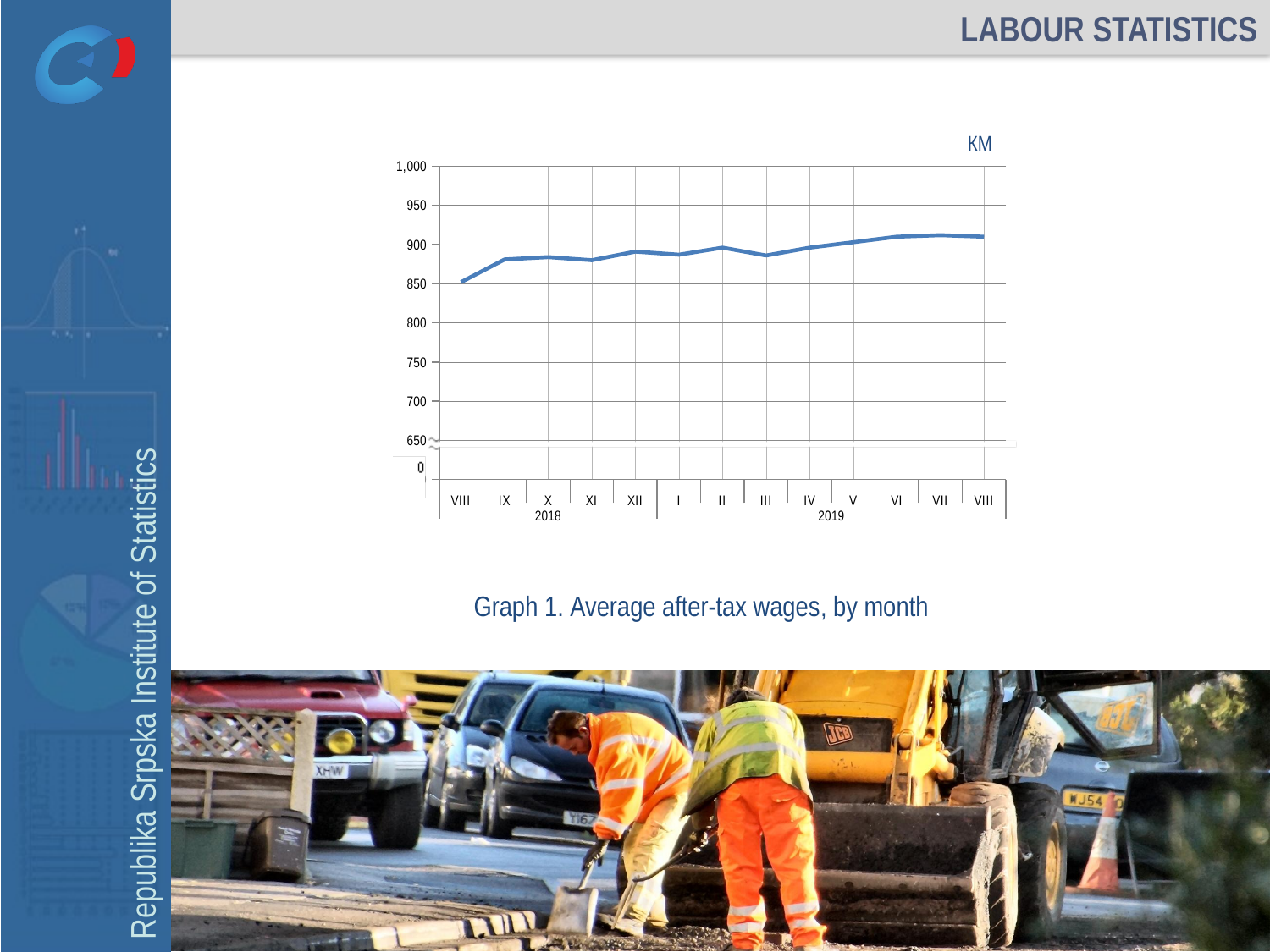
Is the value for VI 2019 greater or less than 850? greater Which is larger, the value for IX 2018 or the value for VII 2019? VII 2019 Which is larger, the value for VIII 2018 or the value for VIII 2019? VIII 2019 Is the value for VIII 2018 greater or less than 900? less Which month has the lowest average after-tax wage on the chart? VIII 2018 What is the title of the chart? Graph 1. Average after-tax wages, by month Do the average after-tax wages generally rise or fall from VIII 2018 to VIII 2019? rise How many monthly data points are plotted on the chart? 13 What unit is shown at the top right of the chart? KM What kind of chart is shown on the slide? line chart Is the value for IX 2018 greater or less than 900? less